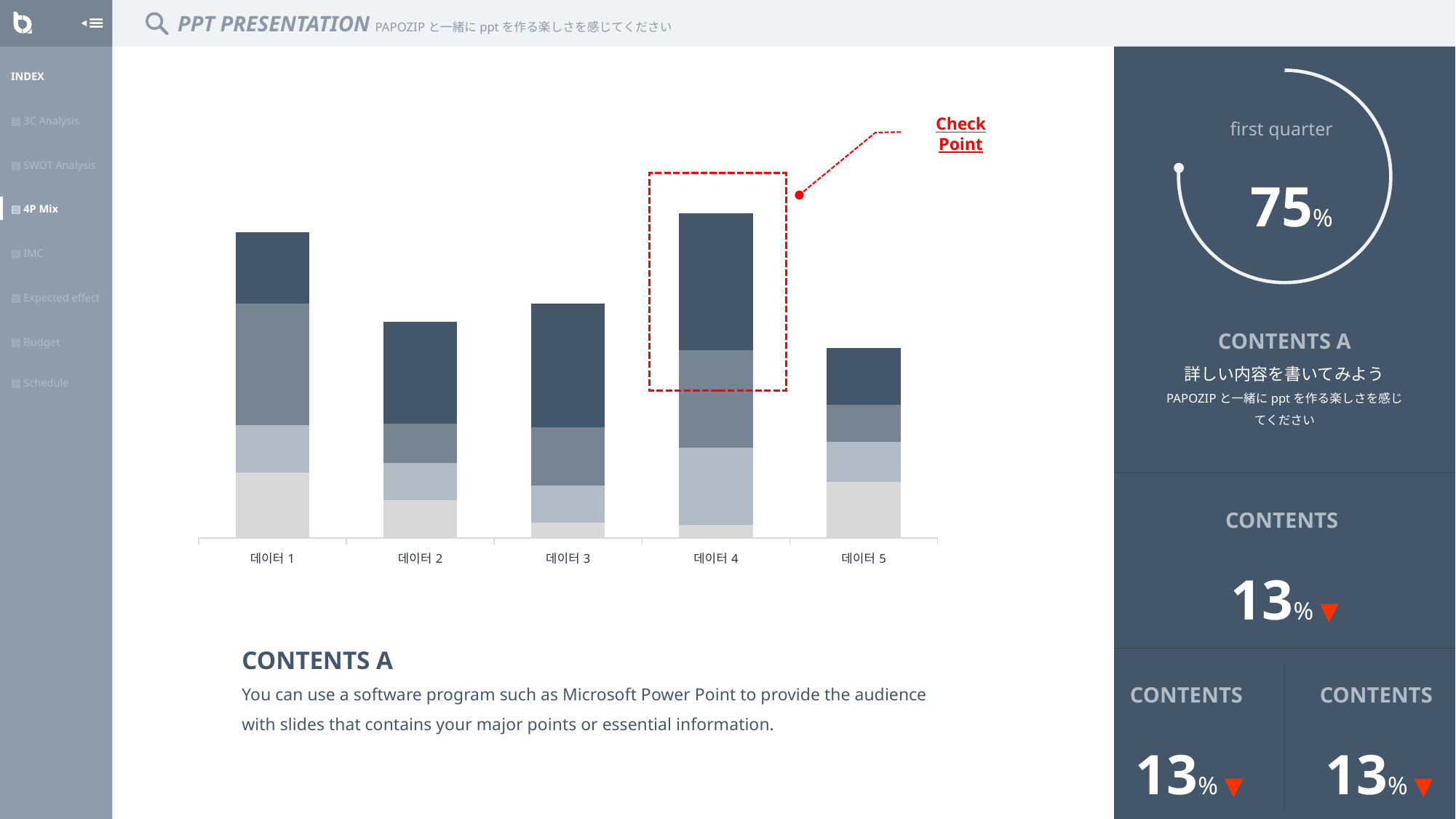
What is the label of the first category on the x axis? 데이터 1 Which category's bar is enclosed by the red dashed 'Check Point' box? 데이터 4 Which category has the shortest stacked bar? 데이터 5 What kind of chart is shown on the slide? stacked bar chart Do the bar heights rise steadily from 데이터 1 to 데이터 5? No How many categories are shown on the x axis of the bar chart? 5 Which stacked bar is taller, 데이터 2 or 데이터 5? 데이터 2 Which stacked bar is taller, 데이터 1 or 데이터 3? 데이터 1 Which stacked bar is taller, 데이터 4 or 데이터 1? 데이터 4 Which category has the tallest stacked bar? 데이터 4 How many segments is each stacked bar divided into? 4